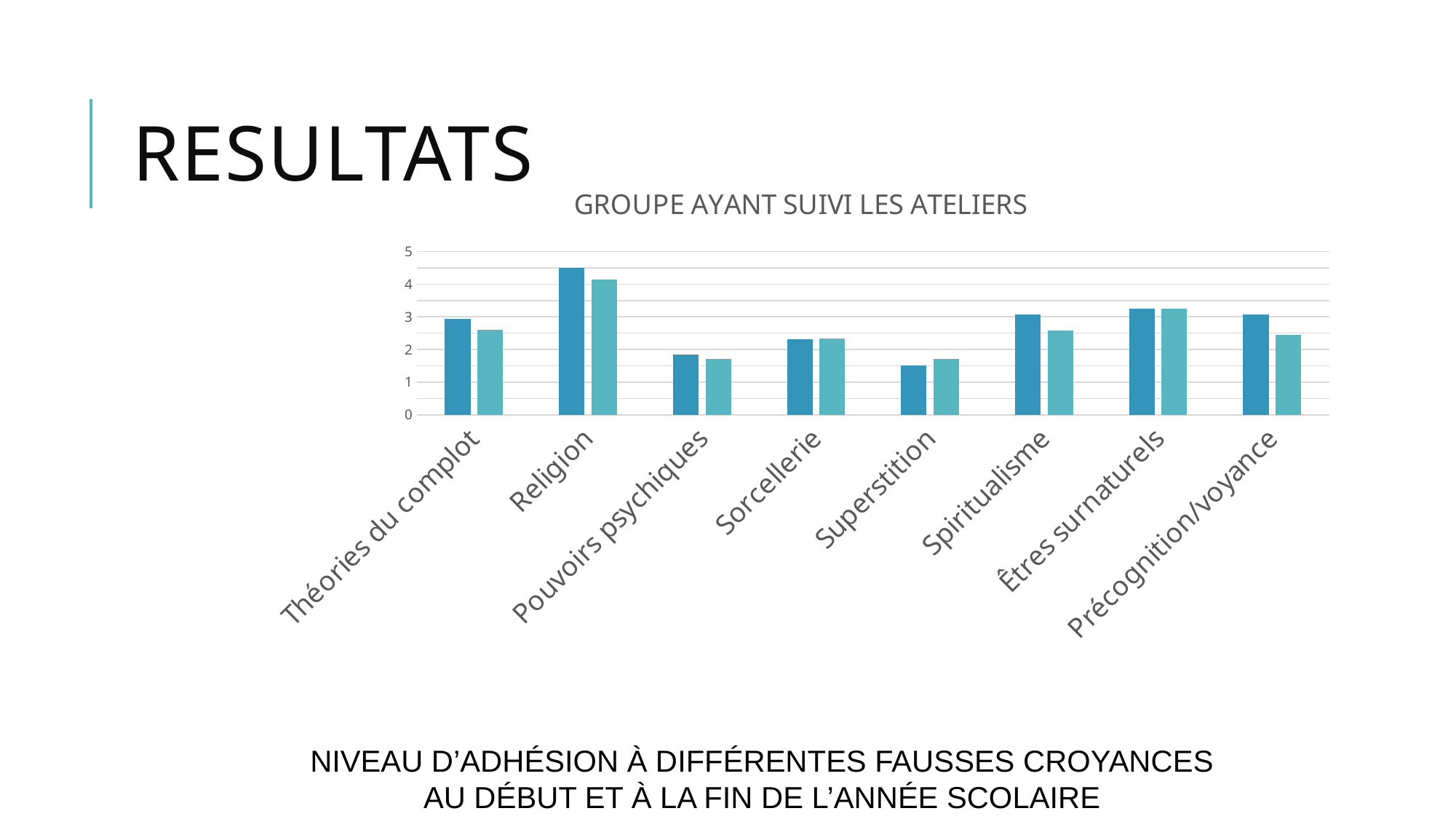
Which category has the lowest dark blue bar in the chart? Superstition Is the light teal bar for Pouvoirs psychiques greater or less than 2? less Is the light teal bar for Êtres surnaturels greater or less than 3? greater What kind of chart is shown on the slide? bar chart For Précognition/voyance, which bar is taller, the dark blue one or the light teal one? the dark blue one Which category has a higher dark blue bar, Religion or Sorcellerie? Religion Is the dark blue bar for Religion greater or less than 4? greater Which category has the highest bars in the chart? Religion How many bars are plotted for each category in the chart? 2 What is the title of the chart? GROUPE AYANT SUIVI LES ATELIERS How many categories are shown on the x axis of the chart? 8